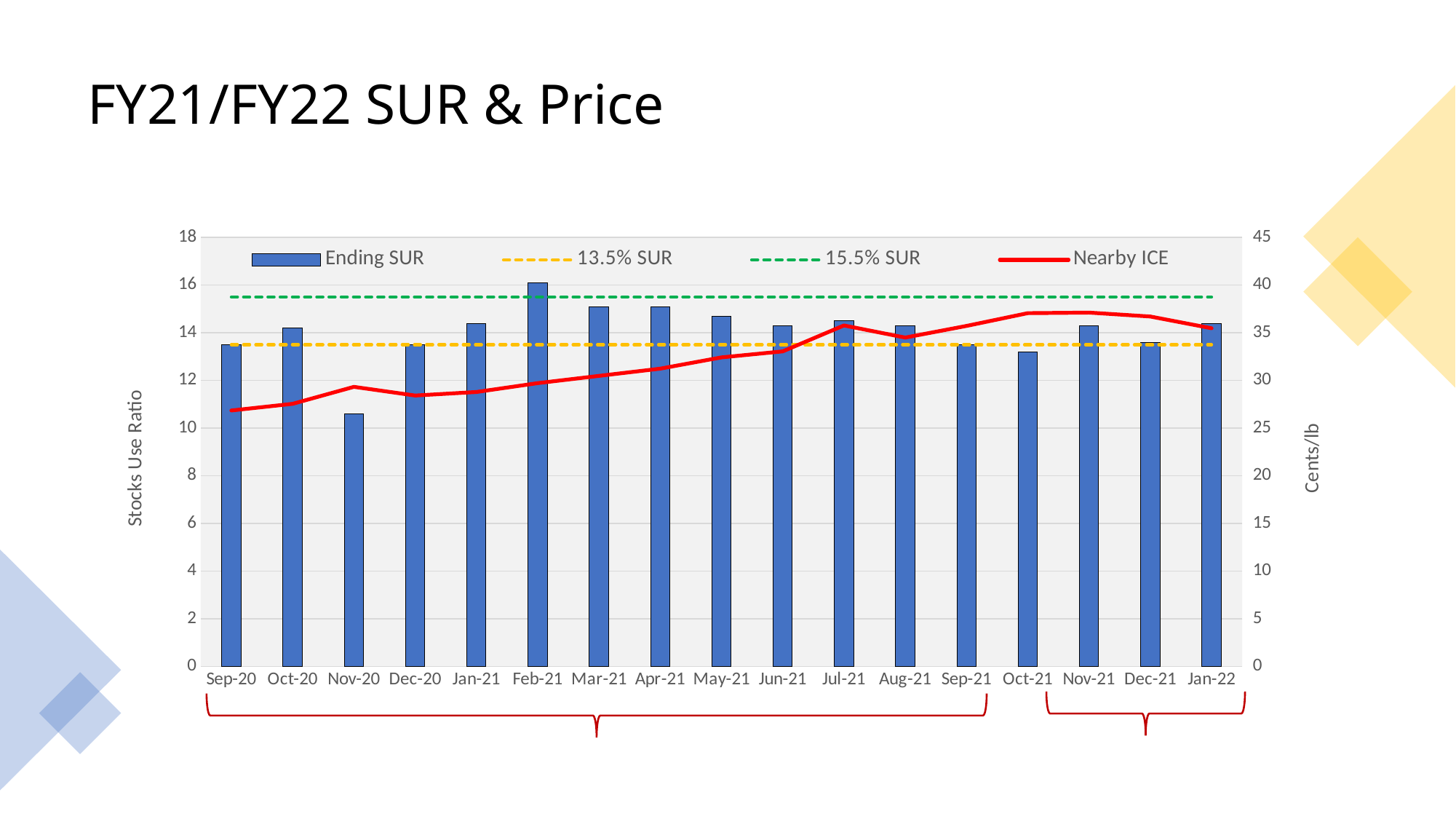
Which month has the highest Ending SUR bar? Feb-21 Is the Ending SUR value for Nov-20 greater or less than 12? less Which month has the lowest Ending SUR bar? Nov-20 How many series does the chart legend list? 4 Which has the larger Ending SUR bar, Mar-21 or Oct-21? Mar-21 What kind of chart is shown on the slide? Bar and line chart What is the title of the chart on the slide? FY21/FY22 SUR & Price Is the Nearby ICE value for Sep-20 greater or less than 30 cents/lb? less Is the Ending SUR value for Oct-21 greater or less than 14? less How many months are shown along the x axis of the chart? 17 Does the Nearby ICE line generally rise or fall from Sep-20 to Jan-22? Rise